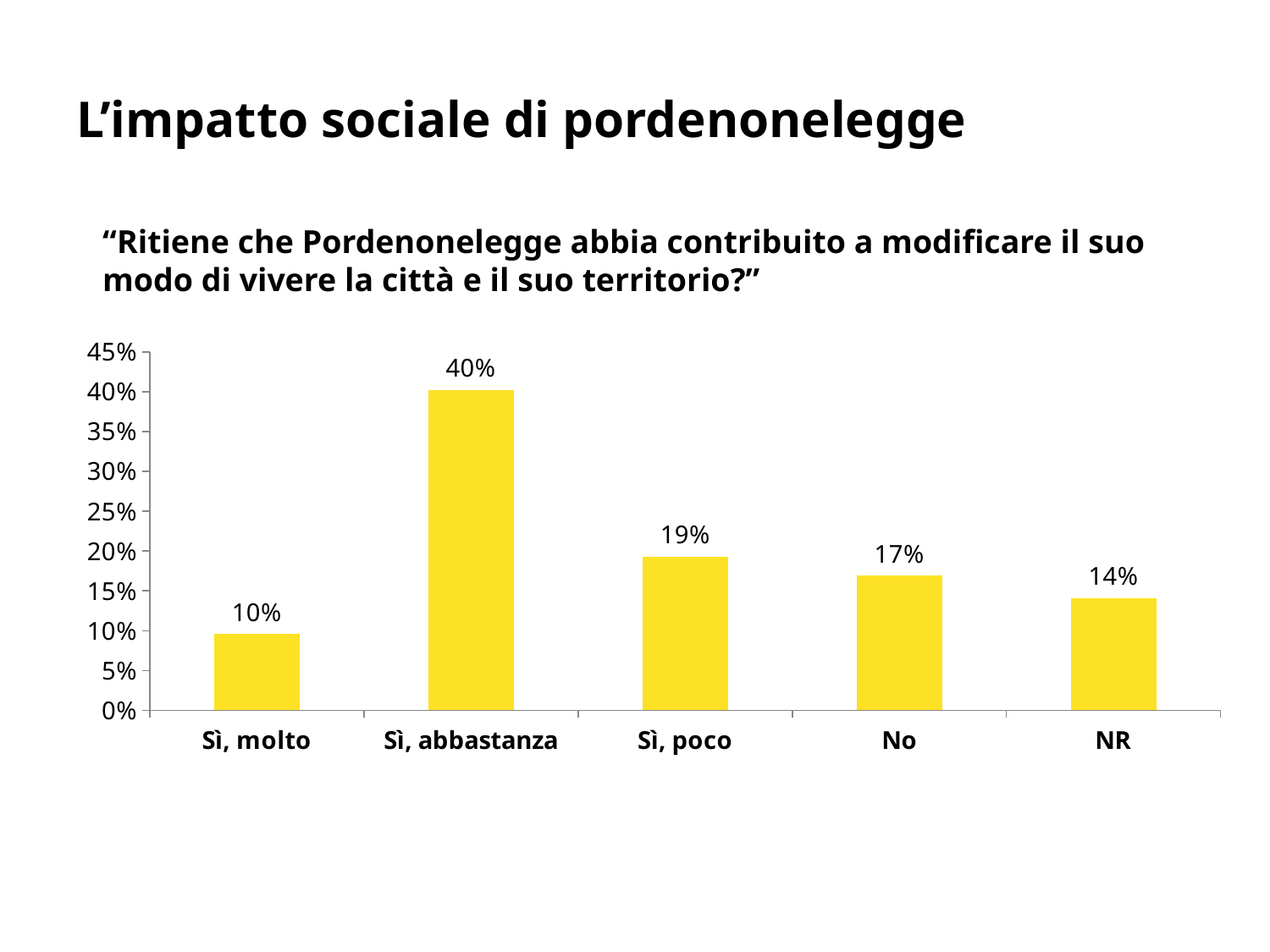
What is the difference between the values for "No" and "NR"? 3% Is the value for "Sì, molto" greater or less than 15%? less What is the maximum value shown on the y axis? 45% Which category has the lowest value? Sì, molto What is the value for "No"? 17% Which is larger, the value for "Sì, poco" or the value for "No"? Sì, poco What is the value for "Sì, abbastanza"? 40% Which category has the highest value? Sì, abbastanza What is the difference between the values for "Sì, abbastanza" and "Sì, poco"? 21% What is the value for "NR"? 14% How many categories are shown on the x axis? 5 What kind of chart is shown on the slide? bar chart